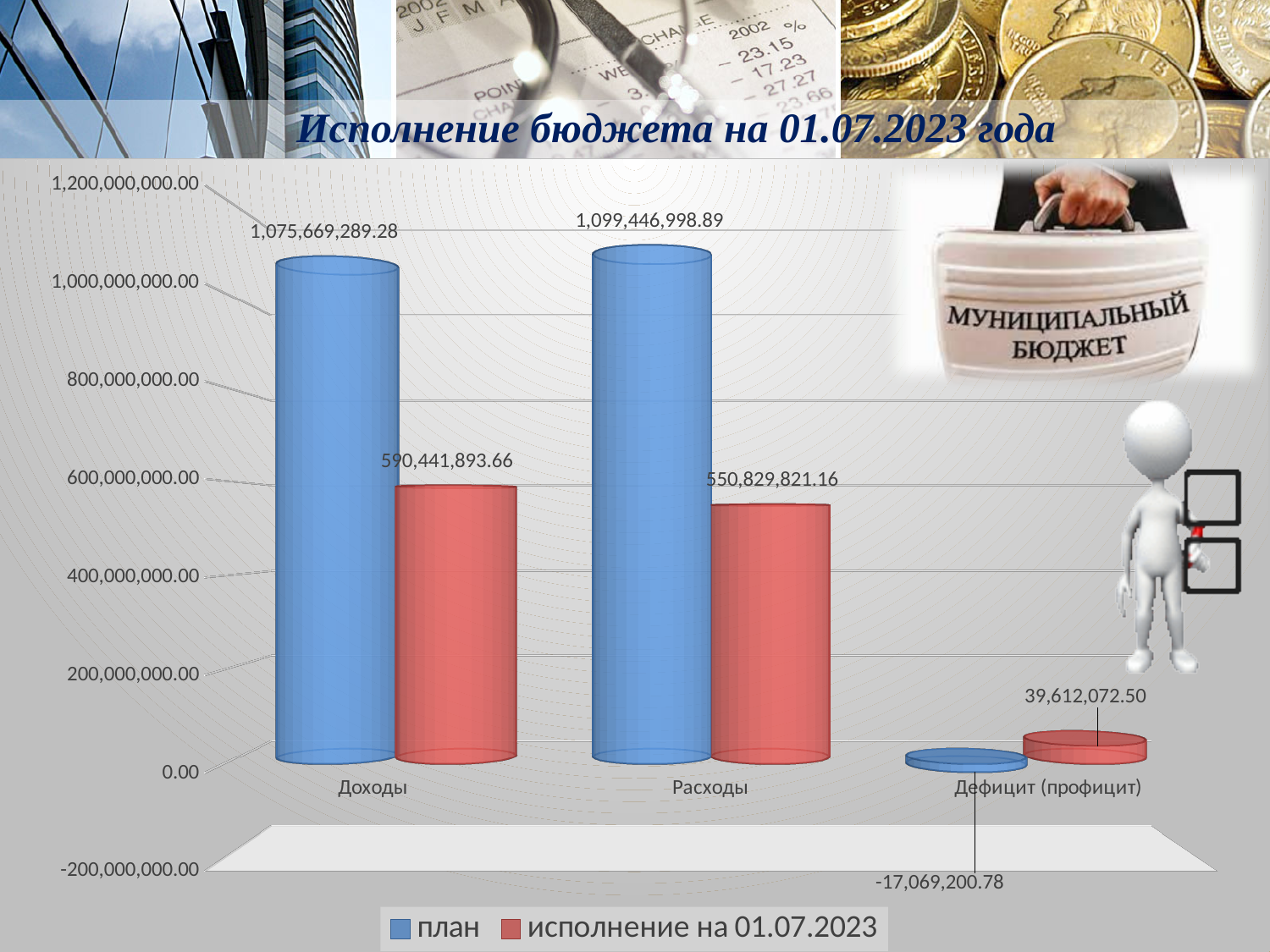
Which is larger: the исполнение на 01.07.2023 value for Доходы or for Расходы? Доходы Which category has the lowest исполнение на 01.07.2023 value? Дефицит (профицит) How many series does the legend list? 2 What is the план value for Доходы? 1,075,669,289.28 What is the difference between the план values for Расходы and Доходы? 23,777,709.61 What is the difference between the план and исполнение на 01.07.2023 values for Доходы? 485,227,395.62 What type of chart is shown on the slide? Bar chart What is the план value for Дефицит (профицит)? -17,069,200.78 What is the исполнение на 01.07.2023 value for Расходы? 550,829,821.16 How many categories are shown on the x axis? 3 Which category has the highest план value? Расходы What is the исполнение на 01.07.2023 value for Дефицит (профицит)? 39,612,072.50